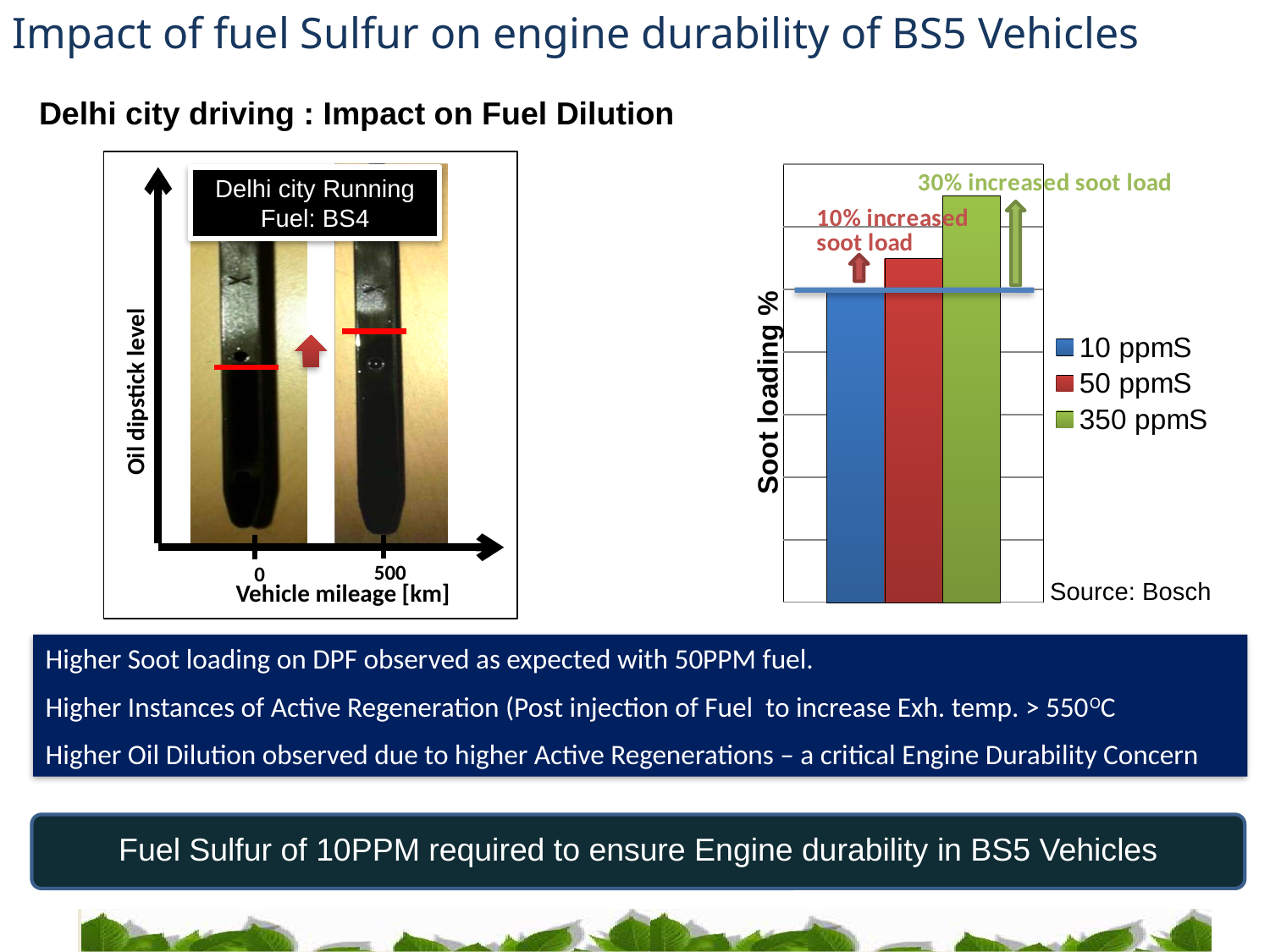
In the soot loading chart, what percentage increase in soot load is annotated for the 350 ppmS bar? 30% Which colour represents the 350 ppmS series in the soot loading chart? green Do the bars in the soot loading chart rise or fall as fuel sulfur content increases from 10 ppmS to 350 ppmS? rise In the soot loading chart, what percentage increase in soot load is annotated for the 50 ppmS bar? 10% In the soot loading chart, is the soot loading for 50 ppmS higher or lower than for 10 ppmS? higher What kind of chart is shown on the right side of the slide? bar chart What is the y-axis label of the bar chart on the right? Soot loading % In the soot loading chart, which fuel sulfur level has the lowest soot loading? 10 ppmS How many series does the legend of the soot loading chart list? 3 How many bars are plotted in the soot loading chart? 3 In the soot loading chart, which fuel sulfur level has the highest soot loading? 350 ppmS In the soot loading chart, is the soot loading for 350 ppmS higher or lower than for 50 ppmS? higher